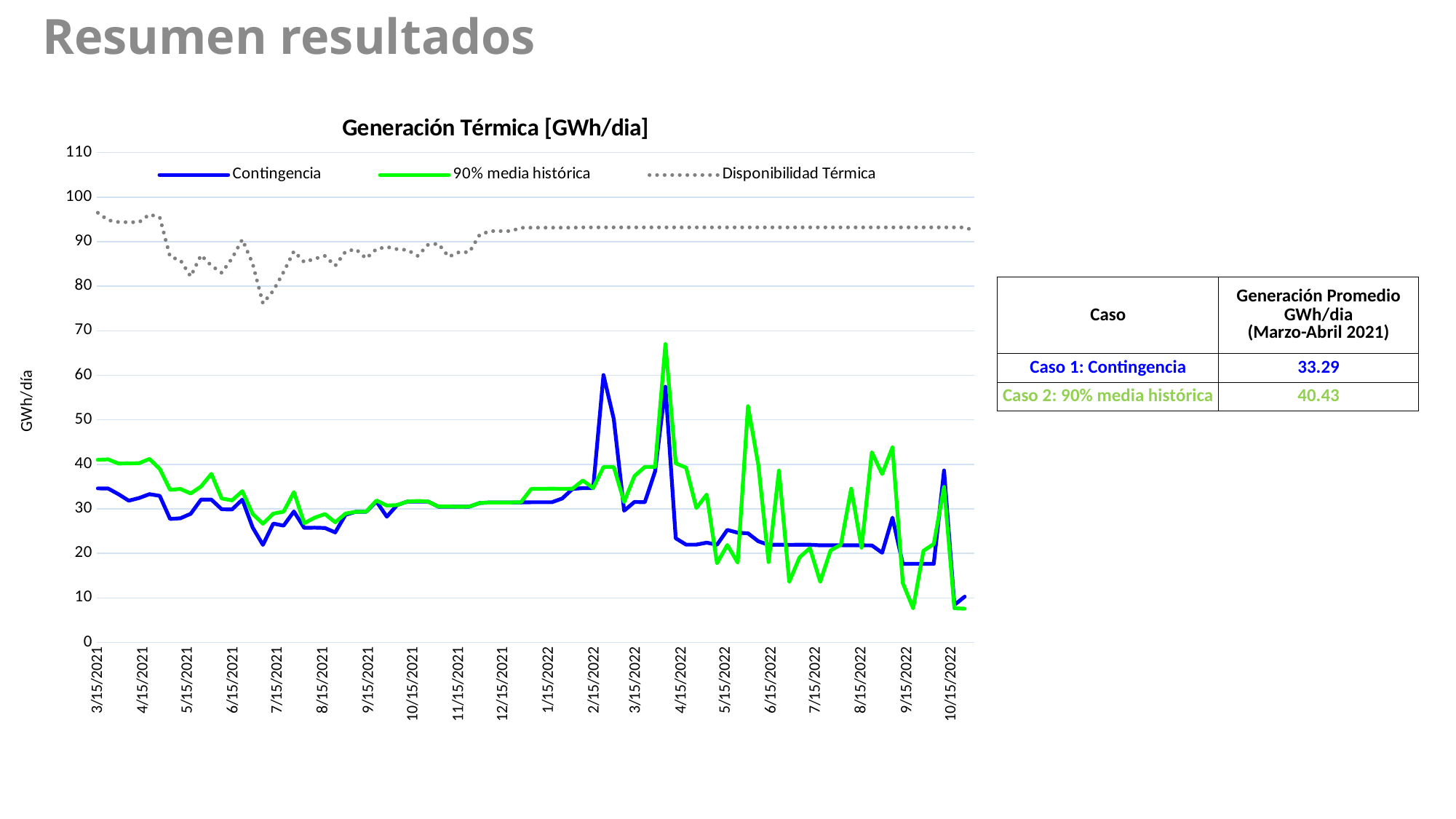
Which series in the chart is drawn as a grey dotted line? Disponibilidad Térmica Is the value of Contingencia at 3/15/2021 greater or less than 40? less Which series has the highest values throughout the chart? Disponibilidad Térmica Is the lowest value of Disponibilidad Térmica (around July 2021) greater or less than 80? less At 3/15/2021, which is larger: Contingencia or 90% media histórica? 90% media histórica How many series does the legend of the chart list? 3 How many date labels are shown on the x axis of the chart? 20 What is the title of the chart? Generación Térmica [GWh/dia] Is the value of 90% media histórica at the last point (after 10/15/2022) greater or less than 10? less What kind of chart is shown on the slide? line chart